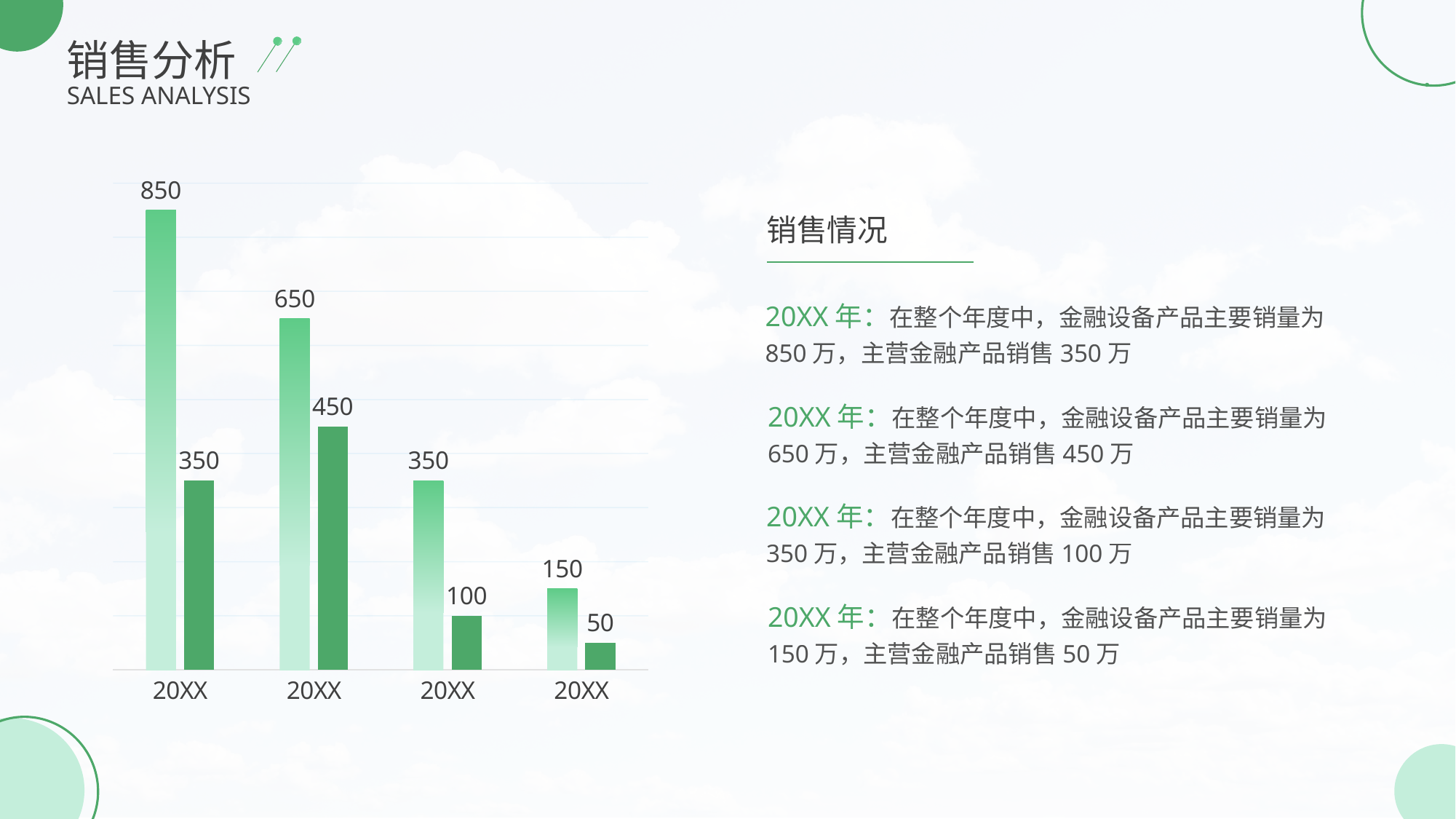
What is the value of the light green bar in the third group from the left? 350 What is the value of the dark green bar in the fourth (rightmost) group? 50 How many category groups are shown along the x axis of the chart? 4 In the second group, which bar is larger, the light green or the dark green? light green Do the light green bars rise or fall from left to right across the chart? fall Which group has the highest light green bar? the first (leftmost) group What is the value of the light green bar in the first (leftmost) group? 850 Which group has the lowest dark green bar? the fourth (rightmost) group What is the value of the dark green bar in the second group from the left? 450 What type of chart is shown on the slide? bar chart What is the difference between the light green and dark green bars in the first group? 500 What is the total of the light green and dark green bars in the fourth group? 200